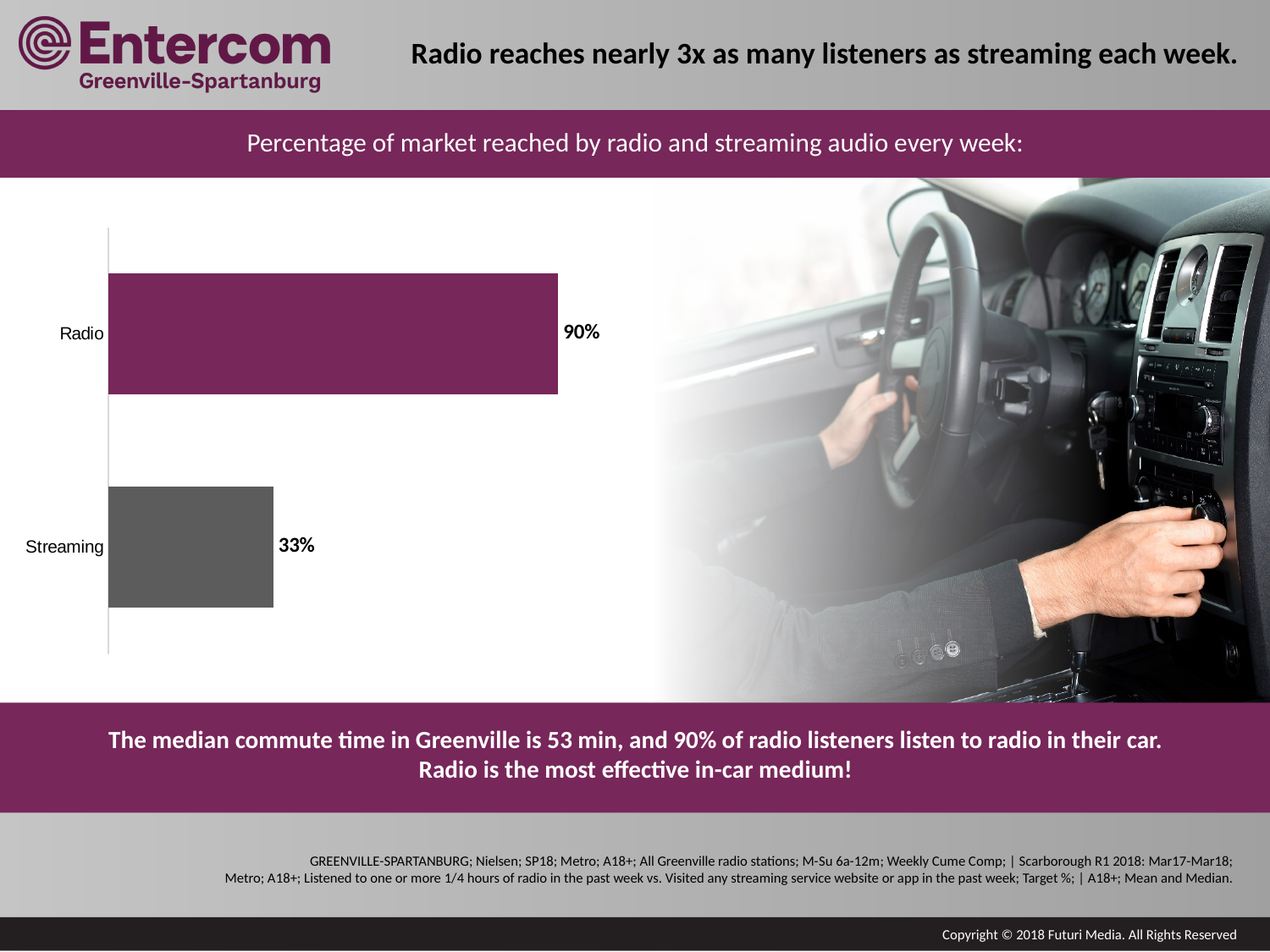
Which category has the lowest value in the chart? Streaming Which is larger, the value for Radio or the value for Streaming? Radio What percentage of the market is reached by Radio every week? 90% What colour is the Radio bar? Purple What percentage of the market is reached by Streaming every week? 33% What kind of chart is shown on the slide? Bar chart What is the difference in percentage points between Radio and Streaming? 57 What is the title of the chart? Percentage of market reached by radio and streaming audio every week: Which category has the highest value in the chart? Radio How many categories are shown in the chart? 2